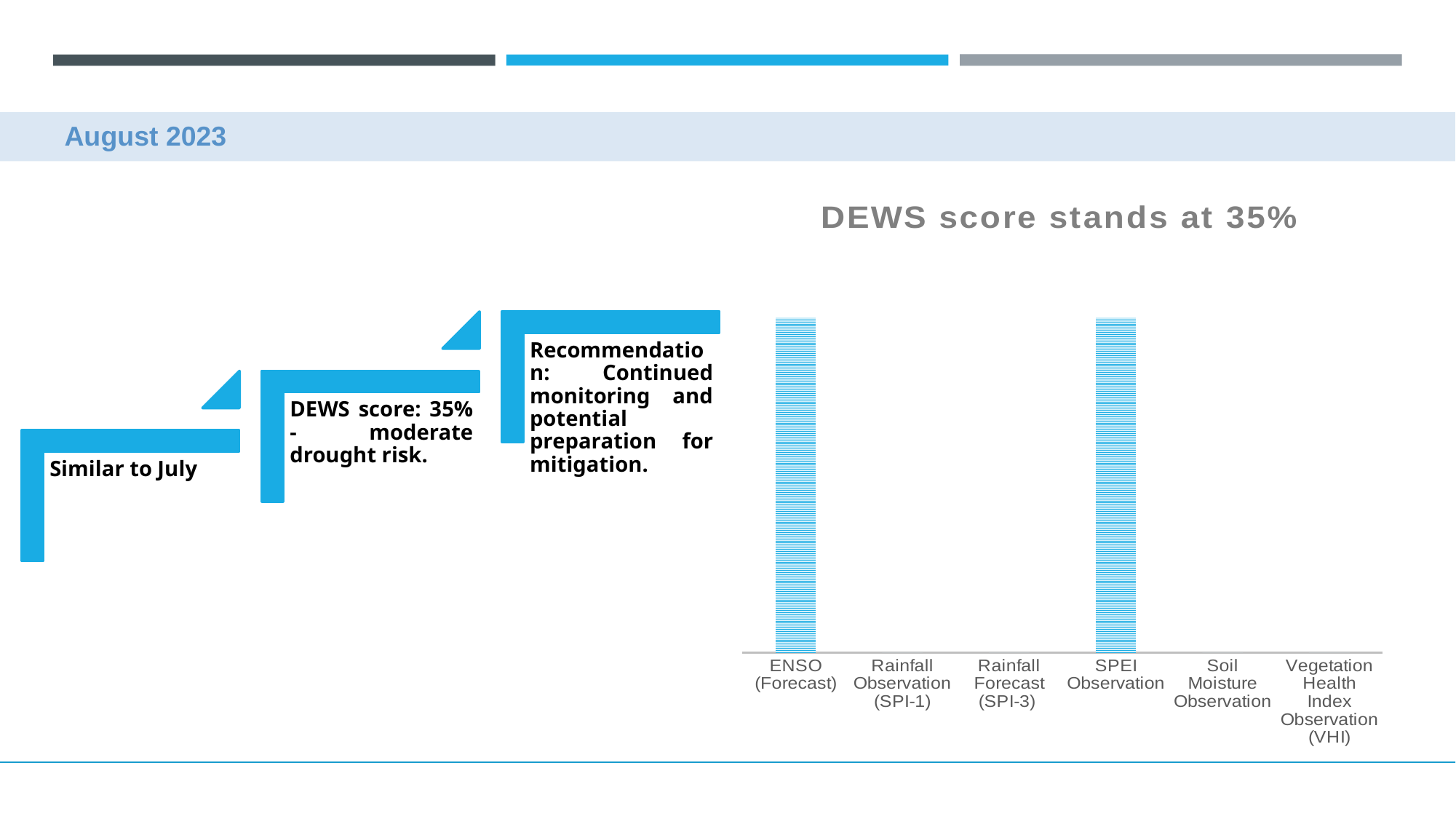
What is the label of the first category on the x axis of the chart? ENSO (Forecast) Is the bar for Vegetation Health Index Observation (VHI) larger or smaller than the bar for ENSO (Forecast)? Smaller What is the title of the chart? DEWS score stands at 35% What kind of chart is shown on the slide? Bar chart How many categories are shown on the x axis of the chart? 6 Which categories in the chart have a visible bar? ENSO (Forecast) and SPEI Observation Is the bar for Rainfall Forecast (SPI-3) larger or smaller than the bar for SPEI Observation? Smaller Is the bar for ENSO (Forecast) larger or smaller than the bar for Rainfall Observation (SPI-1)? Larger